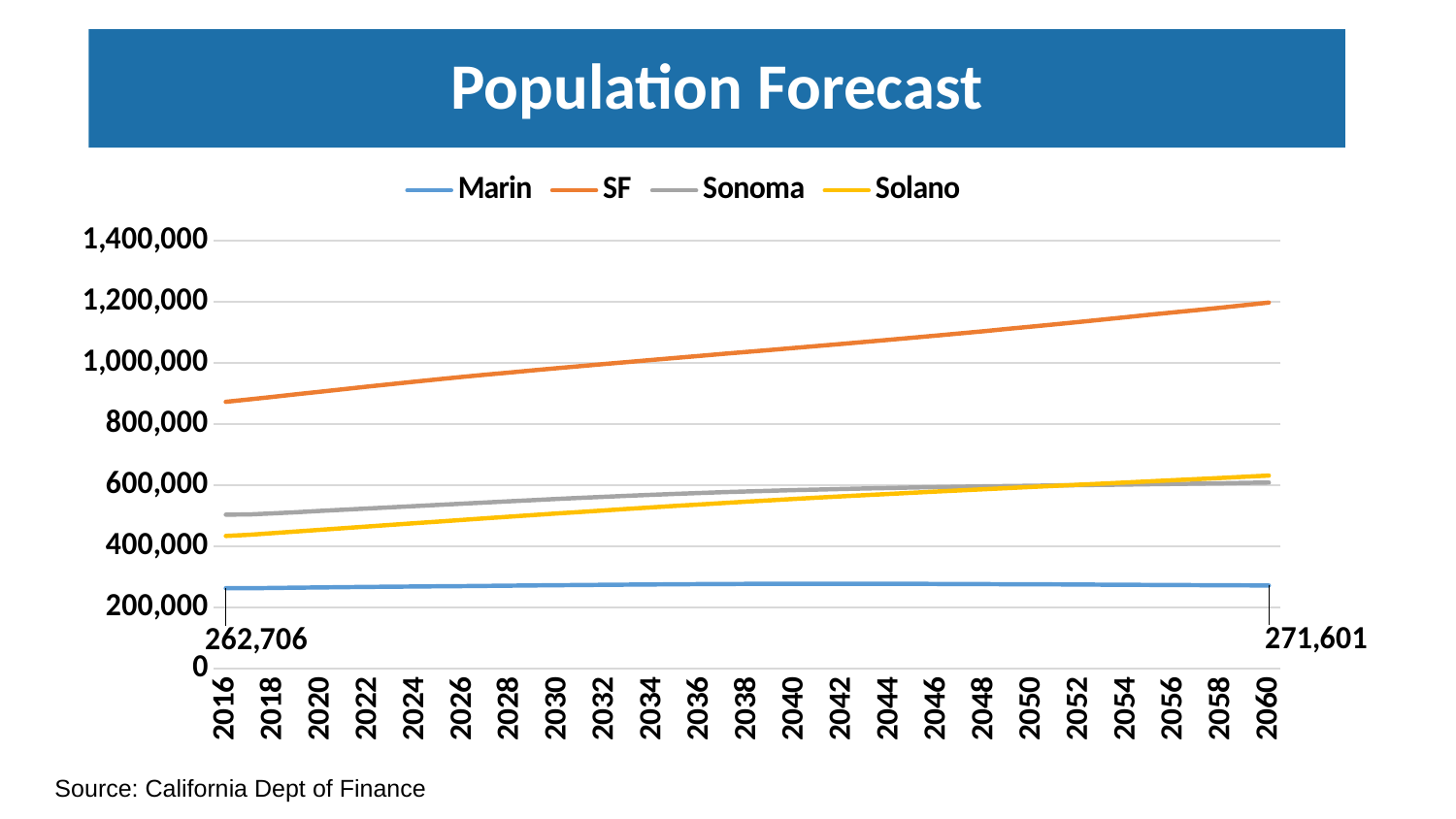
In 2016, which is larger, the value for Sonoma or the value for Solano? Sonoma What is the Marin population value labelled for 2016? 262,706 Is the value for SF in 2060 greater or less than 1,000,000? greater What is the Marin population value labelled for 2060? 271,601 Does the SF line rise or fall from 2016 to 2060? rise What type of chart is shown on the slide? line chart What is the difference between the Marin values labelled for 2060 and 2016? 8,895 Which series has the highest population across the forecast period? SF How many series does the legend list? 4 What is the title of the chart? Population Forecast Is the value for Sonoma in 2016 greater or less than 600,000? less Which series has the lowest population across the forecast period? Marin